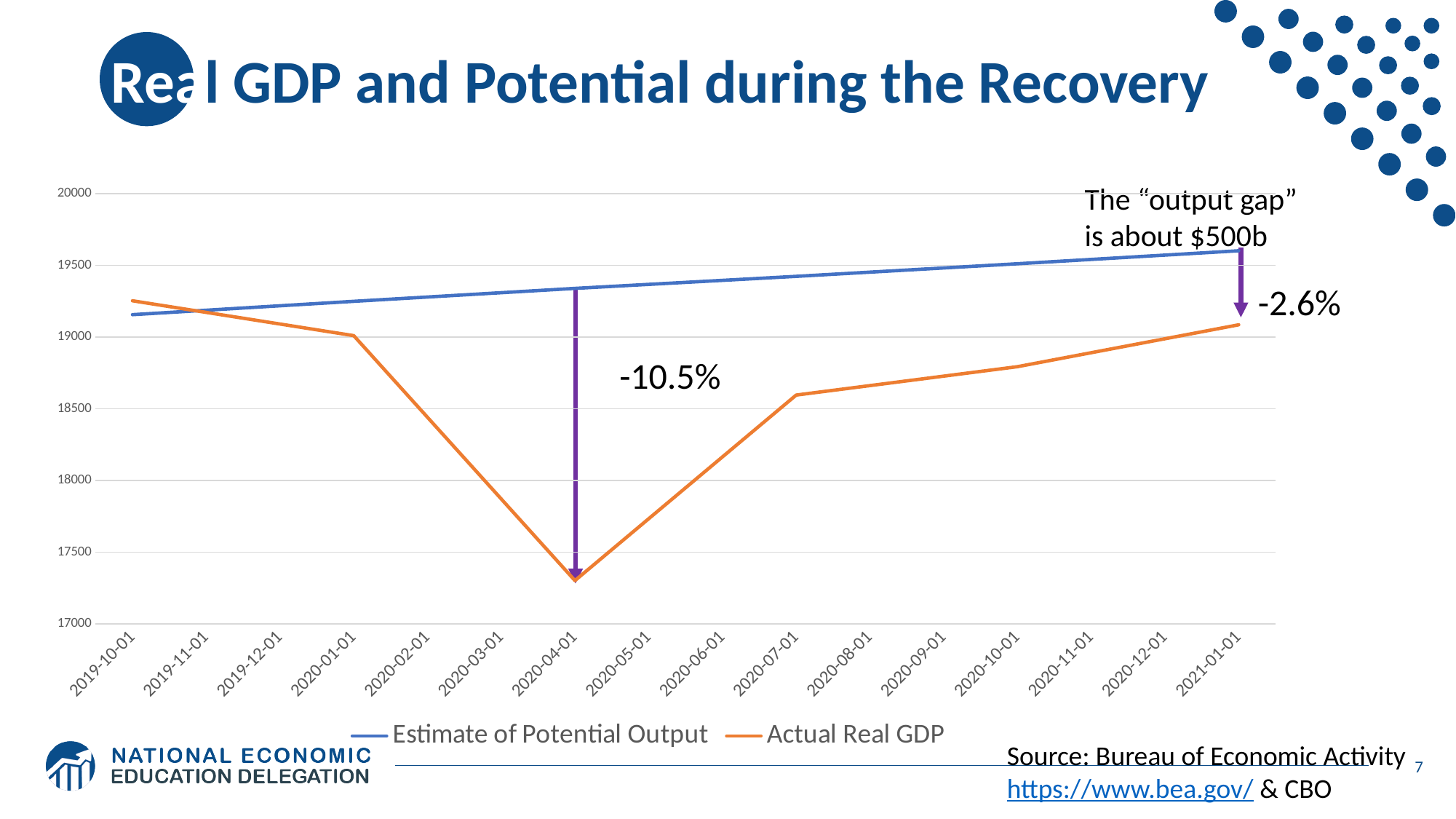
Is the value of the Estimate of Potential Output at 2021-01-01 greater or less than 19500? greater Is the value of Actual Real GDP at 2019-10-01 greater or less than 19000? greater According to the annotation, about how large is the "output gap"? About $500b How many dates are labelled along the x axis? 16 What percentage gap is annotated at 2020-04-01 between potential output and actual real GDP? -10.5% Does the Estimate of Potential Output rise or fall along the x axis? Rise Is the value of Actual Real GDP at 2020-04-01 greater or less than 17500? less At 2020-04-01, which series has the larger value: Estimate of Potential Output or Actual Real GDP? Estimate of Potential Output How many series does the legend list? 2 What percentage gap is annotated at 2021-01-01 between potential output and actual real GDP? -2.6% At which date does Actual Real GDP reach its lowest value? 2020-04-01 What kind of chart is shown on the slide? Line chart